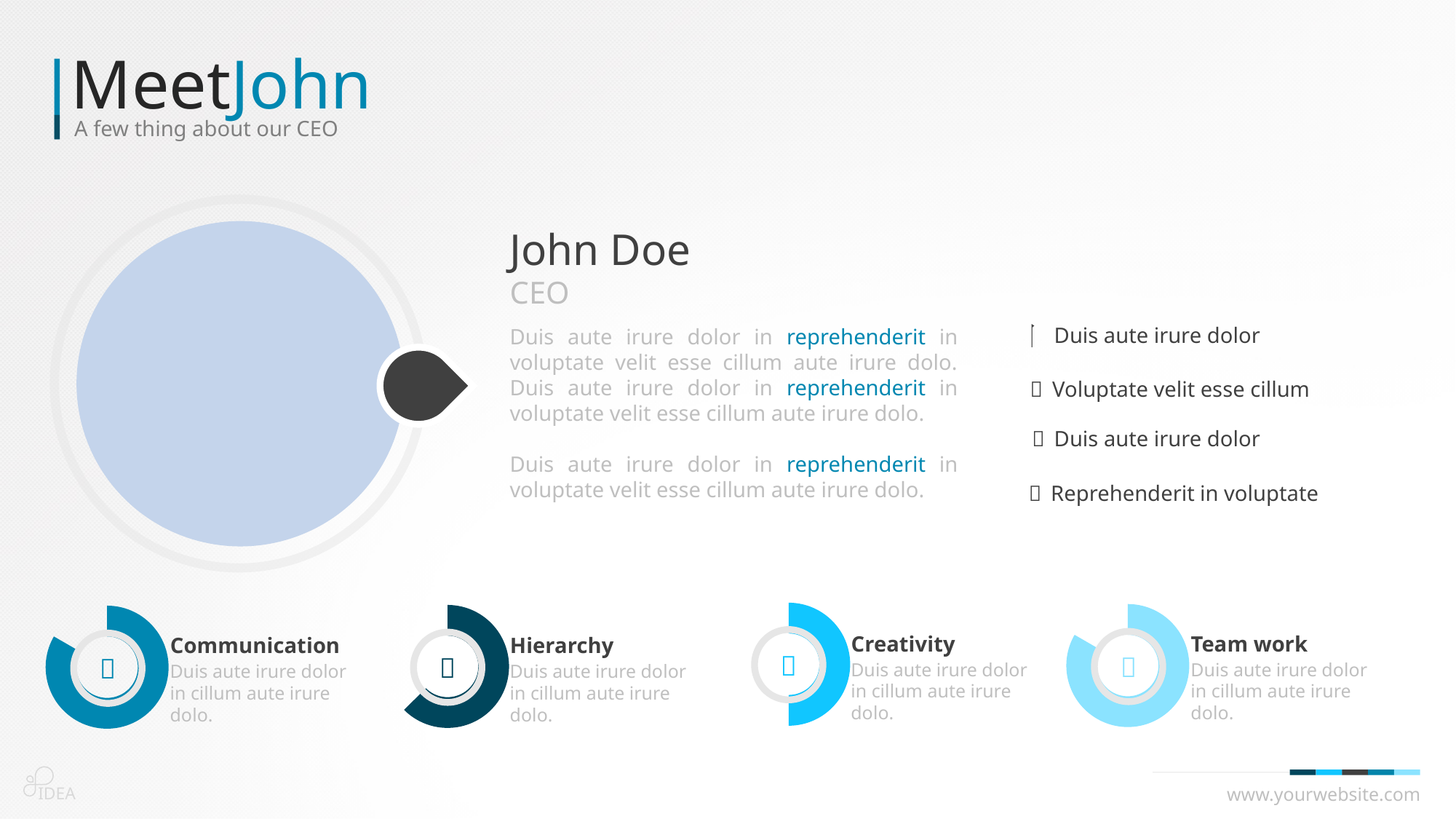
Comparing the bottom ring charts, is the Team work ring filled more or less than the Creativity ring? more Comparing the bottom ring charts, is the Communication ring filled more or less than the Hierarchy ring? more Which label belongs to the first ring chart on the left at the bottom of the slide? Communication What kind of chart is used for the Communication, Hierarchy, Creativity and Team work indicators at the bottom of the slide? doughnut (ring) chart Which label belongs to the last ring chart on the right at the bottom of the slide? Team work How many ring (doughnut) charts are shown along the bottom of the slide? 4